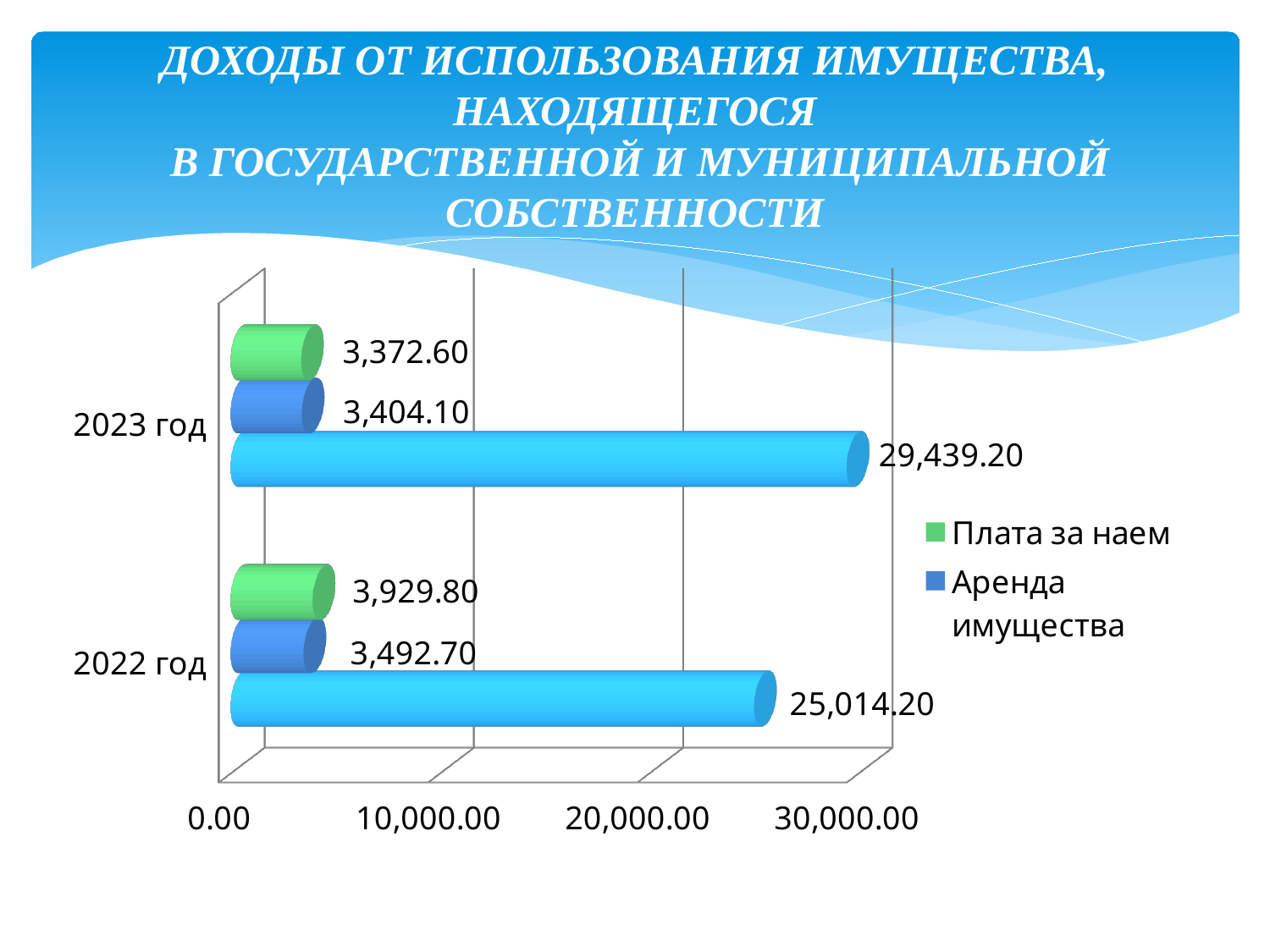
What is the value of Плата за наем for 2022 год? 3,929.80 What is the value of Аренда имущества for 2023 год? 3,404.10 What value is labelled on the longest bar for 2023 год? 29,439.20 What value is labelled on the longest bar for 2022 год? 25,014.20 What is the difference between the longest bar for 2023 год and the longest bar for 2022 год? 4,425.00 What is the value of Плата за наем for 2023 год? 3,372.60 By how much does Плата за наем in 2022 год exceed Плата за наем in 2023 год? 557.20 What is the value of Аренда имущества for 2022 год? 3,492.70 What kind of chart is shown on the slide? Bar chart Which year has the higher value for Плата за наем, 2022 год or 2023 год? 2022 год What is the difference between Аренда имущества in 2022 год and in 2023 год? 88.60 How many year categories are shown on the chart? 2